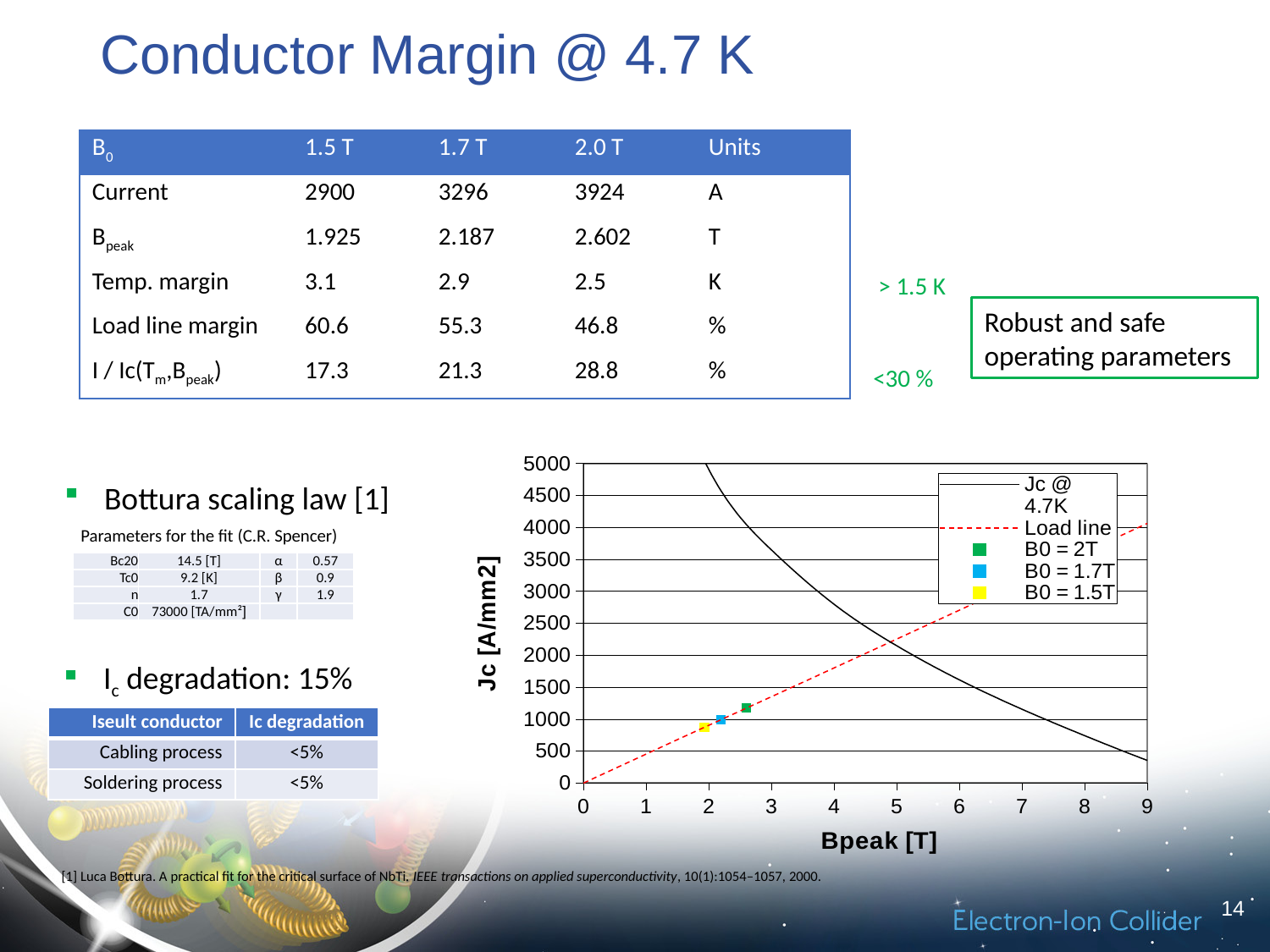
Does the Load line rise or fall as Bpeak increases? rise Which of the plotted operating points, B0 = 2T or B0 = 1.5T, has the higher Jc value? B0 = 2T Which of the three B0 operating points has the lowest Jc value? B0 = 1.5T Is the Jc value of the B0 = 2T point greater or less than 1500? less How many B0 operating points are plotted on the chart? 3 How many entries does the chart legend list? 5 What is the label of the x axis of the chart? Bpeak [T] What kind of chart is shown on the slide? line chart What is the label of the y axis of the chart? Jc [A/mm2] Does the Jc @ 4.7K curve rise or fall as Bpeak increases? fall Is the Jc value of the B0 = 1.5T point greater or less than 1000? less Is the Jc value of the B0 = 2T point greater or less than 1000? greater